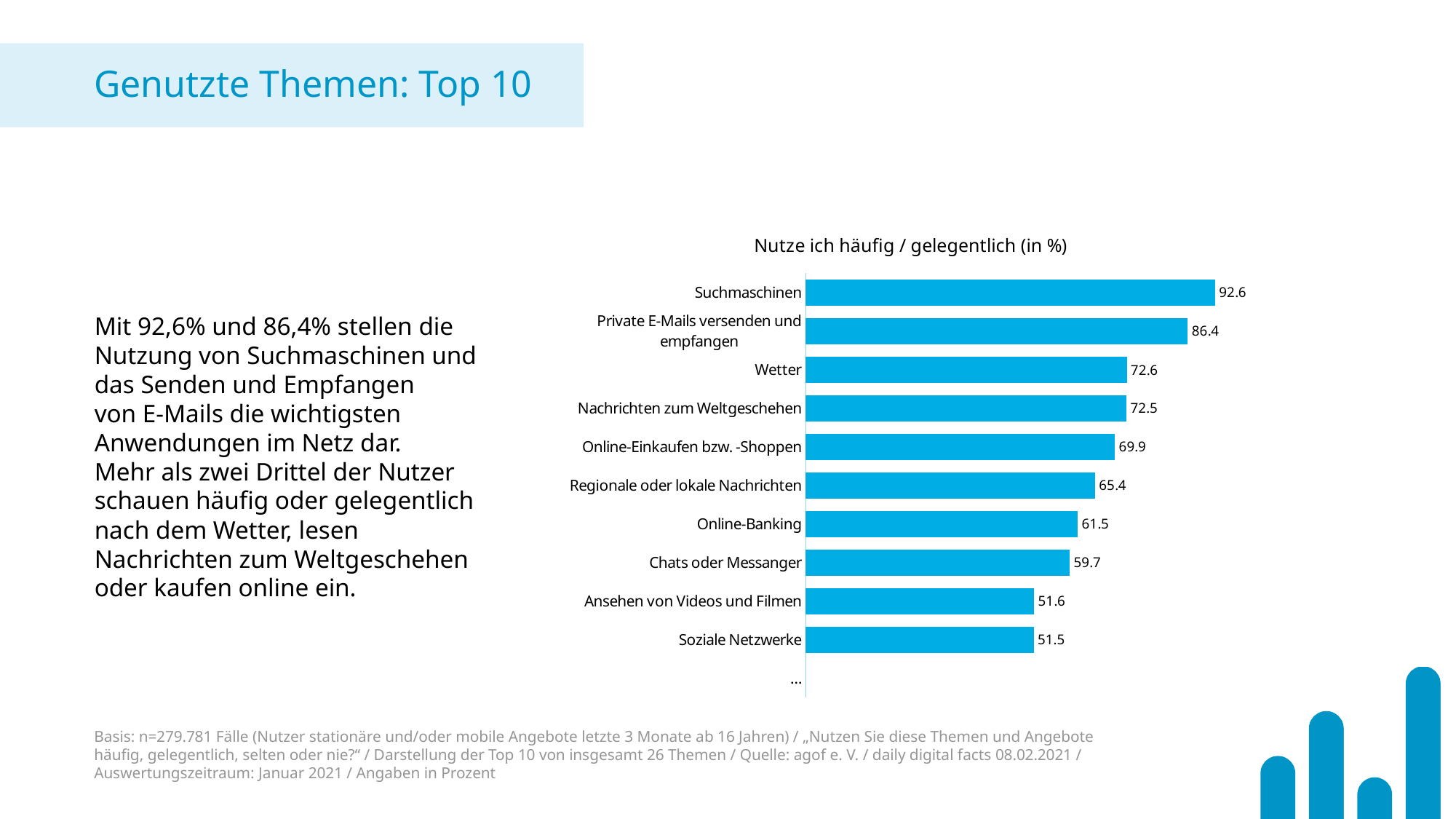
Which is larger, the value for Online-Einkaufen bzw. -Shoppen or the value for Chats oder Messanger? Online-Einkaufen bzw. -Shoppen What is the value for Suchmaschinen? 92.6 What is the difference between the values for Suchmaschinen and Private E-Mails versenden und empfangen? 6.2 How many labelled categories with bars are shown in the chart? 10 What kind of chart is shown on the slide? Bar chart What is the value for Online-Banking? 61.5 Which labelled category has the lowest value? Soziale Netzwerke Which category has the highest value? Suchmaschinen What is the value for Ansehen von Videos und Filmen? 51.6 What is the difference between the values for Wetter and Online-Banking? 11.1 What is the value for Regionale oder lokale Nachrichten? 65.4 What is the title of the chart? Nutze ich häufig / gelegentlich (in %)